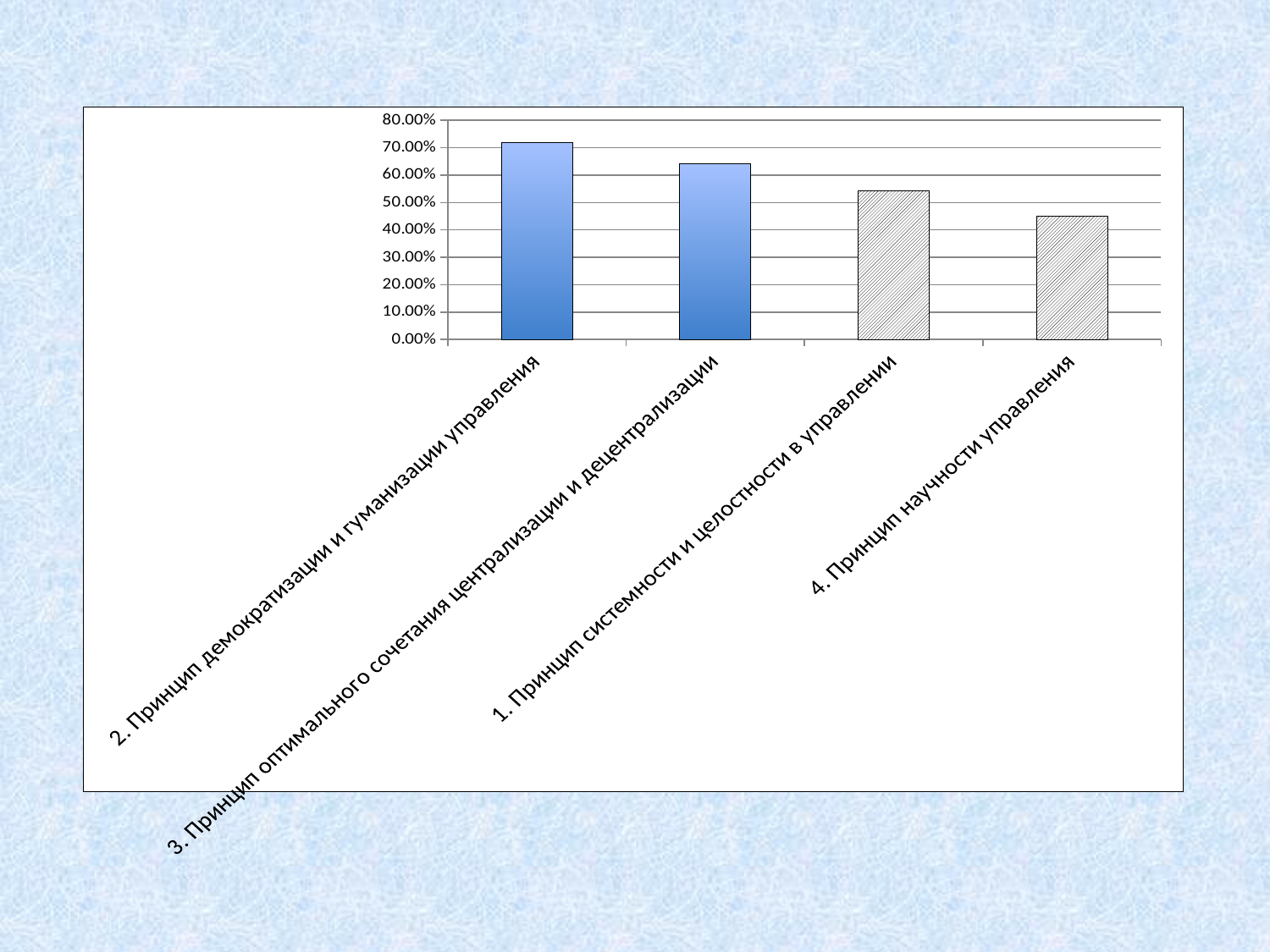
Which is larger: the value for "1. Принцип системности и целостности в управлении" or the value for "4. Принцип научности управления"? 1. Принцип системности и целостности в управлении Is the value for "2. Принцип демократизации и гуманизации управления" greater or less than 70.00%? greater Which category has the lowest value? 4. Принцип научности управления How many categories are plotted in the chart? 4 Is the value for "1. Принцип системности и целостности в управлении" greater or less than 60.00%? less Which is larger: the value for "3. Принцип оптимального сочетания централизации и децентрализации" or the value for "2. Принцип демократизации и гуманизации управления"? 2. Принцип демократизации и гуманизации управления Do the bar values rise or fall from left to right along the x axis? fall Is the value for "4. Принцип научности управления" greater or less than 50.00%? less What kind of chart is shown on the slide? bar chart What is the highest value shown on the vertical axis? 80.00% Which category has the highest value? 2. Принцип демократизации и гуманизации управления